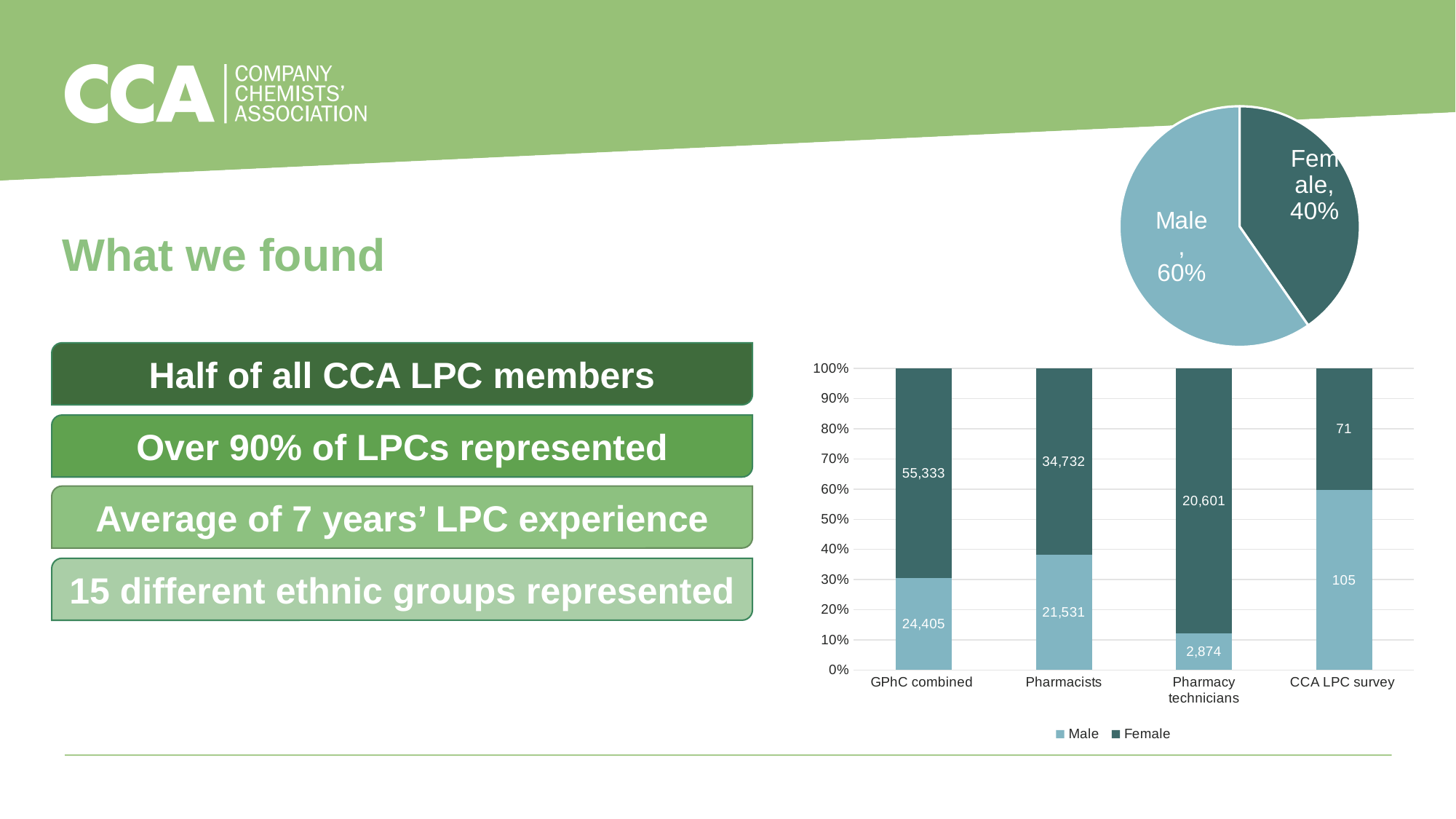
In the stacked bar chart at the bottom right, what is the difference between the Female and Male values for GPhC combined? 30,928 In the stacked bar chart at the bottom right, what is the Male value for Pharmacists? 21,531 In the stacked bar chart at the bottom right, how many series does the legend list? 2 In the stacked bar chart at the bottom right, is the Male share of the Pharmacy technicians bar greater or less than 20%? less In the stacked bar chart at the bottom right, what is the Female value for Pharmacy technicians? 20,601 In the pie chart at the top right, what share of the pie is Female? 40% What kind of chart is the chart at the top right of the slide? pie chart In the stacked bar chart at the bottom right, what is the Female value for CCA LPC survey? 71 In the stacked bar chart at the bottom right, how many categories are shown on the x axis? 4 In the stacked bar chart at the bottom right, is the Male value larger or the Female value larger for Pharmacy technicians? Female In the pie chart at the top right, what share of the pie is Male? 60% In the stacked bar chart at the bottom right, what is the total of the Male and Female values for CCA LPC survey? 176